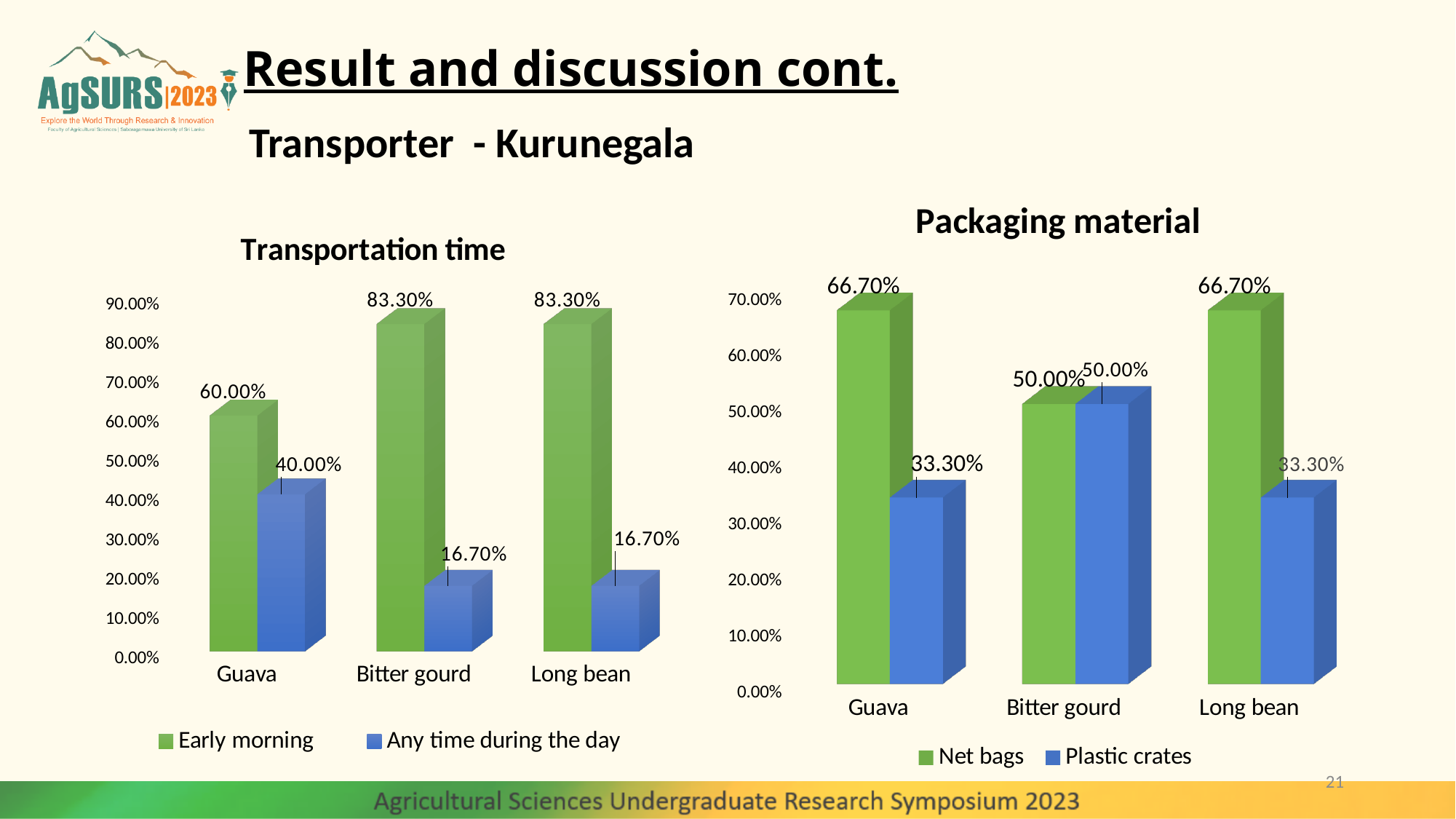
In the Packaging material chart, what is the value for Net bags for Bitter gourd? 50.00% In the Packaging material chart, which colour represents Plastic crates? Blue In the Transportation time chart, how many series does the legend list? 2 In the Transportation time chart, what is the value for Early morning for Guava? 60.00% In the Packaging material chart, how many categories are shown on the x axis? 3 In the Transportation time chart, what is the difference between Early morning and Any time during the day for Guava? 20.00% What kind of chart is the Packaging material chart? Bar chart In the Transportation time chart, which category has the lowest value for Any time during the day? Bitter gourd and Long bean (both 16.70%) In the Transportation time chart, what is the value for Any time during the day for Bitter gourd? 16.70% In the Packaging material chart, what is the difference between Net bags and Plastic crates for Long bean? 33.40% In the Packaging material chart, what is the value for Plastic crates for Guava? 33.30% In the Packaging material chart, which is larger for Long bean, Net bags or Plastic crates? Net bags